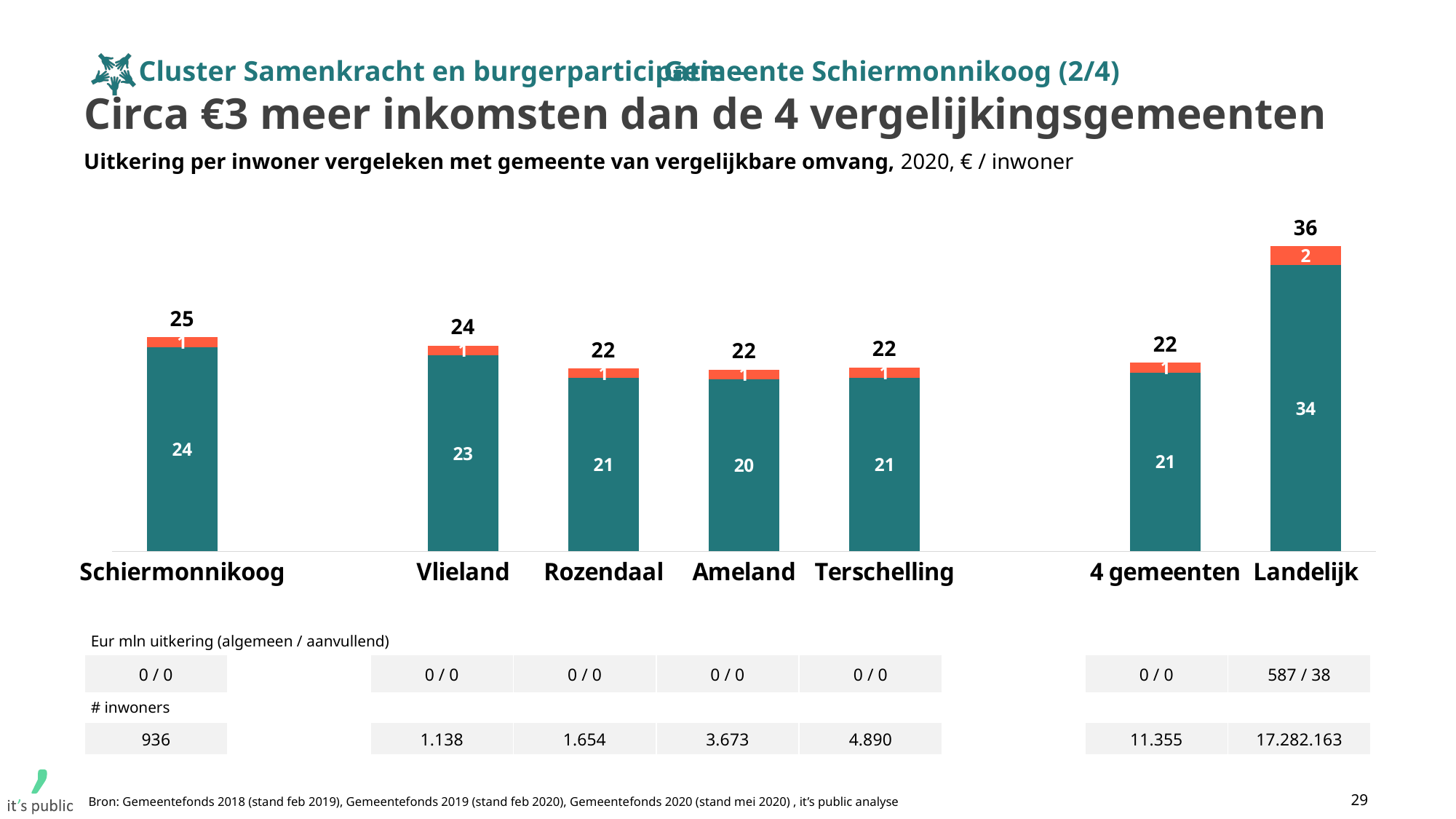
Which category has the highest total value? Landelijk What is the total value shown above the bar for Landelijk? 36 How many categories are shown on the x axis of the chart? 7 Which is larger, the total for Schiermonnikoog or the total for Vlieland? Schiermonnikoog What is the total of the stacked bar for Terschelling? 22 What is the value of the orange (upper) segment for Landelijk? 2 What kind of chart is shown on the slide? Stacked bar chart What is the value of the teal (lower) segment for Schiermonnikoog? 24 What is the difference between the total for Schiermonnikoog and the total for 4 gemeenten? 3 Which category has the lowest teal (lower) segment value? Ameland What is the difference between the total for Landelijk and the total for Schiermonnikoog? 11 What is the total value shown above the bar for Vlieland? 24